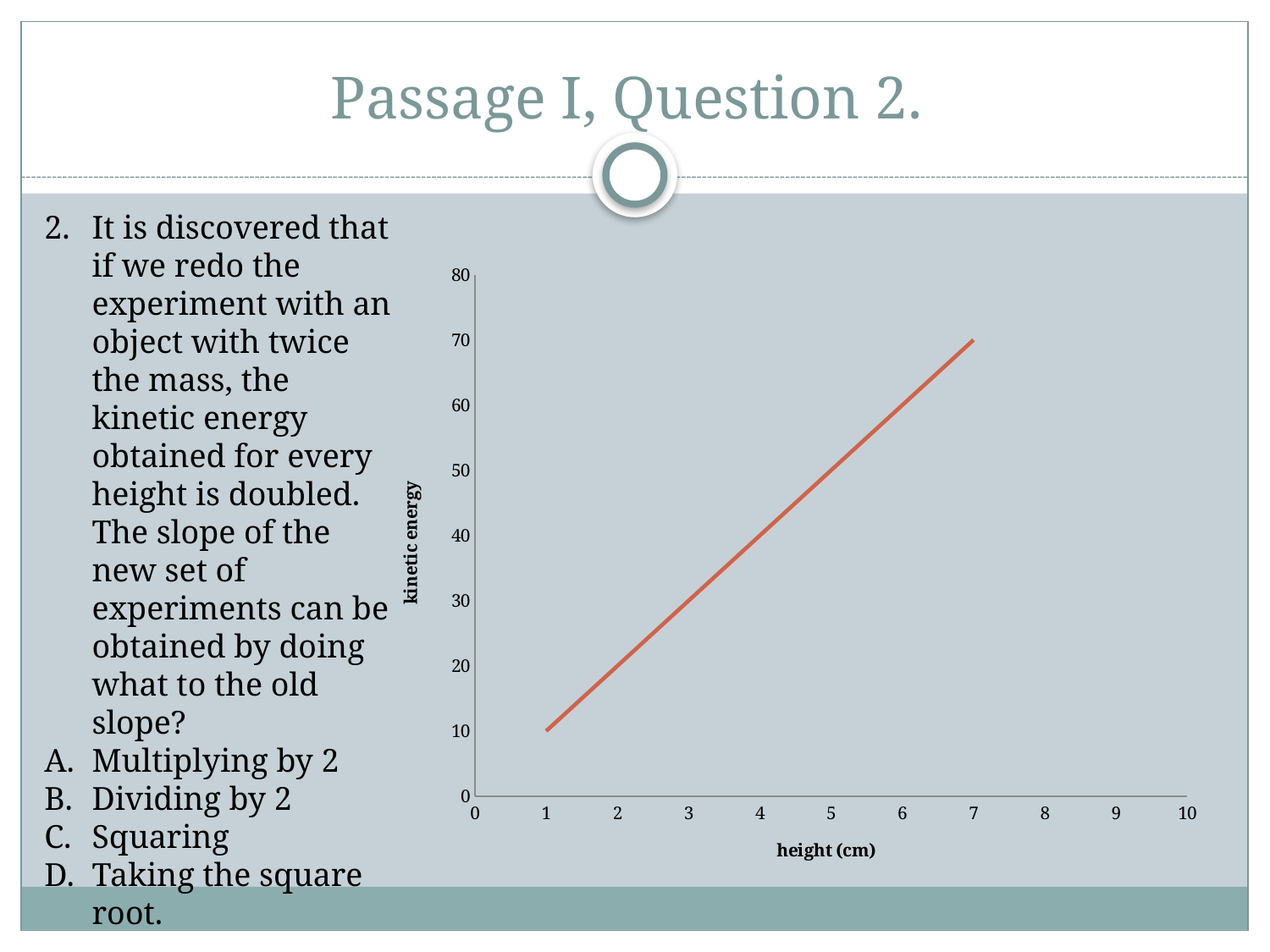
What is the difference in kinetic energy between a height of 7 cm and a height of 1 cm? 60 Is the kinetic energy at a height of 2 cm greater or less than 30? less Is the kinetic energy at a height of 3 cm greater or less than 40? less Does the kinetic energy rise or fall as height increases? rise What is the label of the x axis? height (cm) What is the kinetic energy at a height of 1 cm? 10 Is the kinetic energy at a height of 6 cm greater or less than 50? greater What is the kinetic energy at a height of 7 cm? 70 What kind of chart is shown on the slide? line chart Which height has the larger kinetic energy, 1 cm or 7 cm? 7 cm What is the label of the y axis? kinetic energy